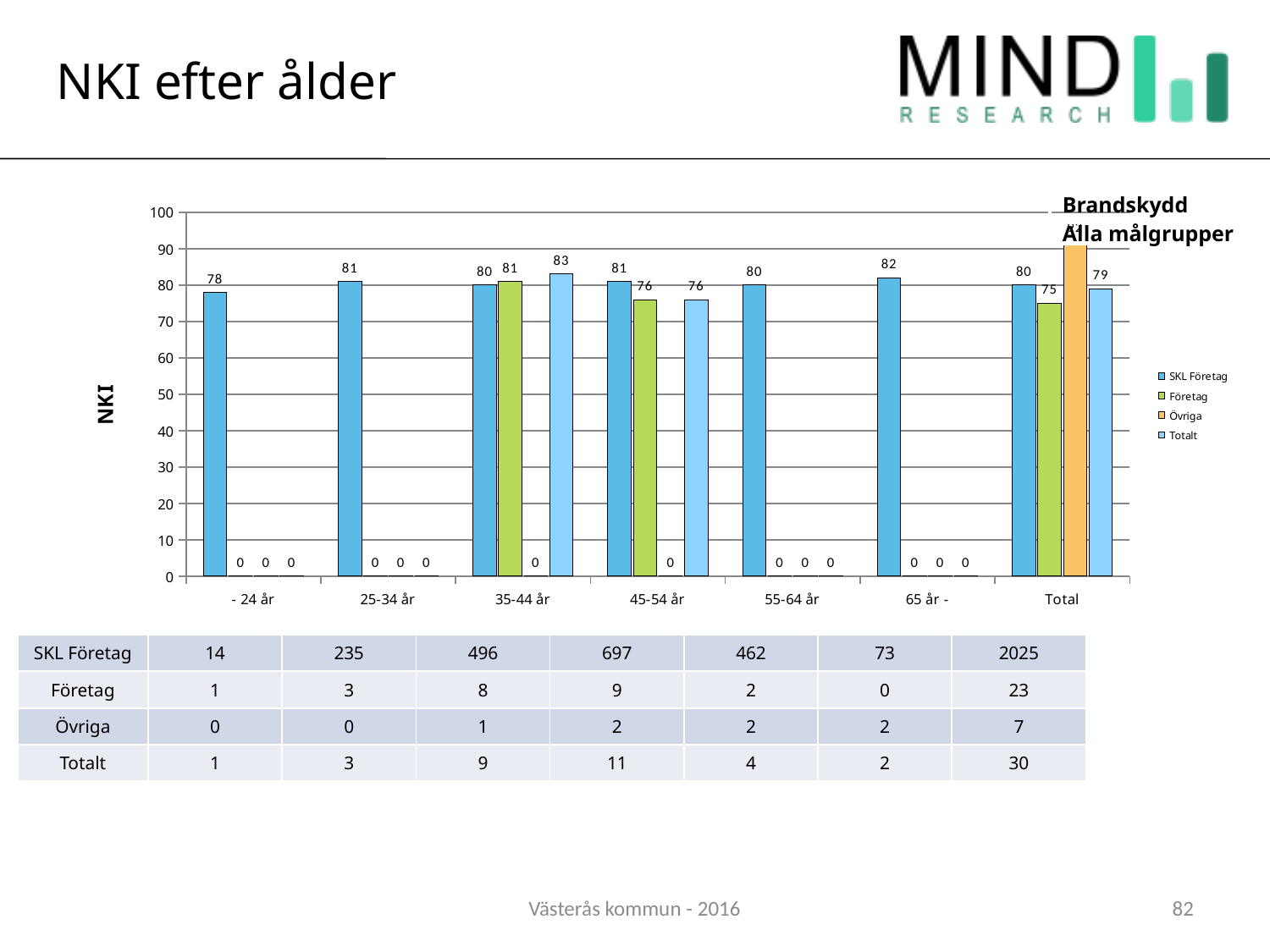
What is the Företag value in the Total category? 75 What type of chart is shown on the slide? bar chart How many categories are shown on the x axis of the chart? 7 How many series does the legend list? 4 What is the Totalt value for the 35-44 år age group? 83 Which has the higher Totalt value: 35-44 år or 45-54 år? 35-44 år What is the NKI value for SKL Företag in the - 24 år age group? 78 Is the Övriga value in the Total category greater or less than 80? greater What is the title of the vertical axis? NKI In the 45-54 år group, how much higher is the SKL Företag value than the Företag value? 5 Which age group has the lowest SKL Företag value? - 24 år Which age group has the highest SKL Företag value? 65 år -